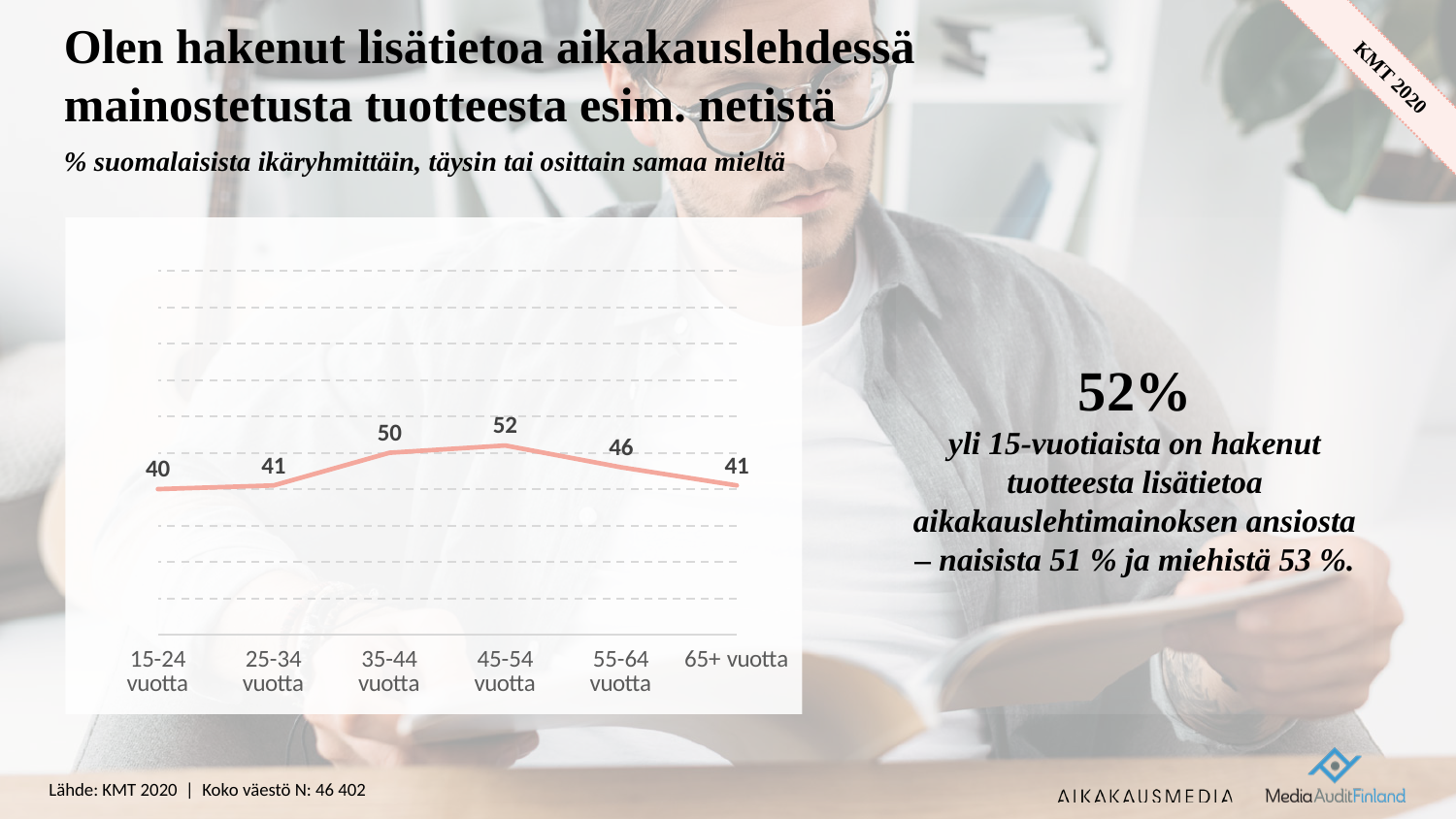
What is the value for the 65+ vuotta age group? 41 What is the value for the 15-24 vuotta age group? 40 Which age group has the highest value? 45-54 vuotta What is the value for the 45-54 vuotta age group? 52 Which is larger, the value for 35-44 vuotta or the value for 55-64 vuotta? 35-44 vuotta What kind of chart is shown on the slide? Line chart What is the value for the 55-64 vuotta age group? 46 Do the values rise or fall from 45-54 vuotta to 65+ vuotta? Fall How many age groups are plotted on the chart? 6 Which age group has the lowest value? 15-24 vuotta What is the difference between the values for 35-44 vuotta and 55-64 vuotta? 4 What is the difference between the values for 45-54 vuotta and 15-24 vuotta? 12